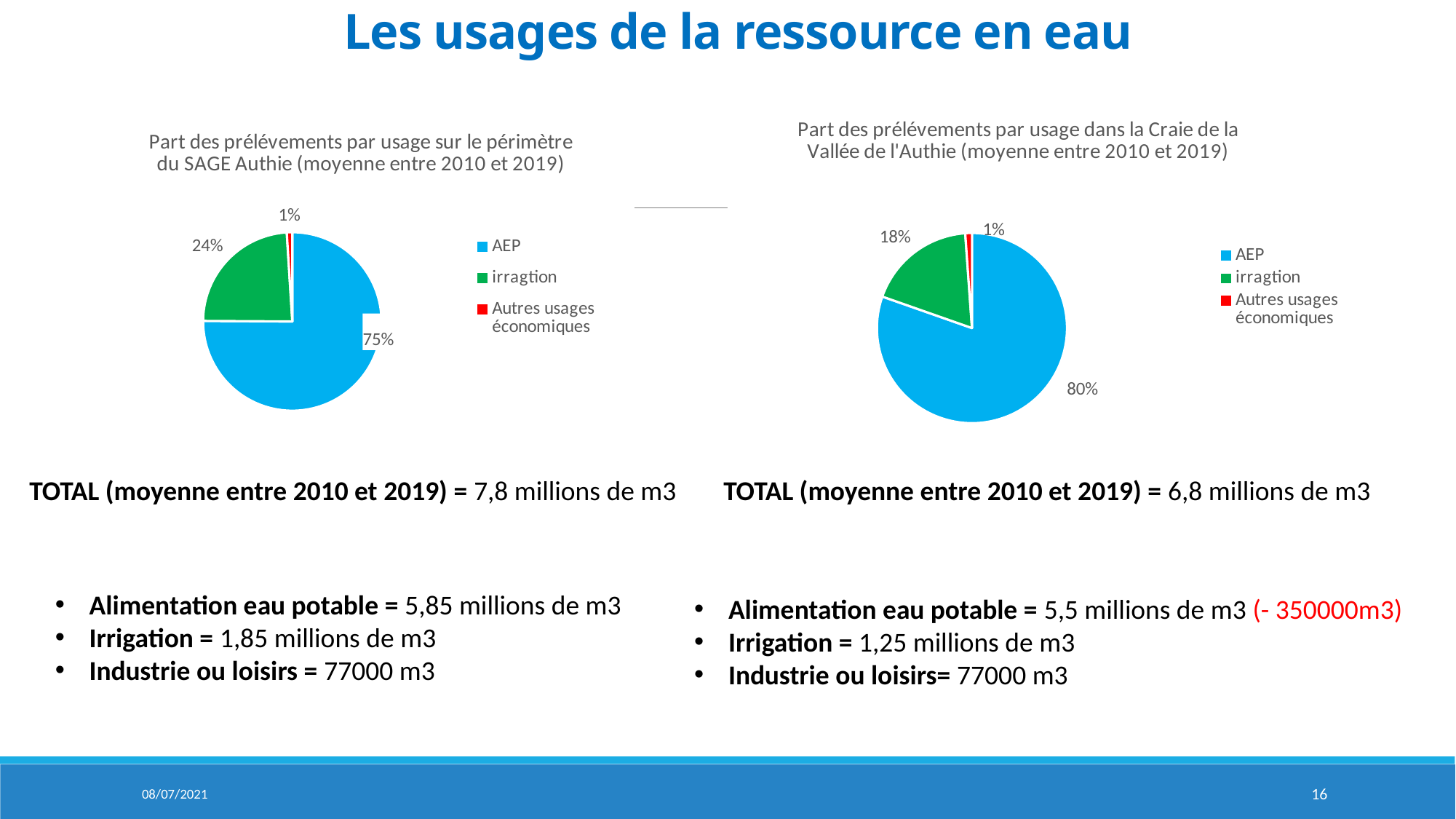
In the left pie chart (SAGE Authie), which category has the smallest share? Autres usages économiques Is the irragtion share larger in the left pie chart (SAGE Authie) or in the right pie chart (Craie de la Vallée de l'Authie)? Left pie chart (SAGE Authie) In the left pie chart (SAGE Authie), what is the difference between the AEP share and the irragtion share? 51% In the right pie chart (Craie de la Vallée de l'Authie), what colour represents AEP? Blue What type of chart is used on the left of the slide? Pie chart In the left pie chart (SAGE Authie), what share does irragtion have? 24% In the right pie chart (Craie de la Vallée de l'Authie), what share does AEP have? 80% In the left pie chart (Part des prélévements par usage sur le périmètre du SAGE Authie), what share does AEP have? 75% How many categories does the right pie chart (Craie de la Vallée de l'Authie) show? 3 In the right pie chart (Craie de la Vallée de l'Authie), which category has the largest share? AEP